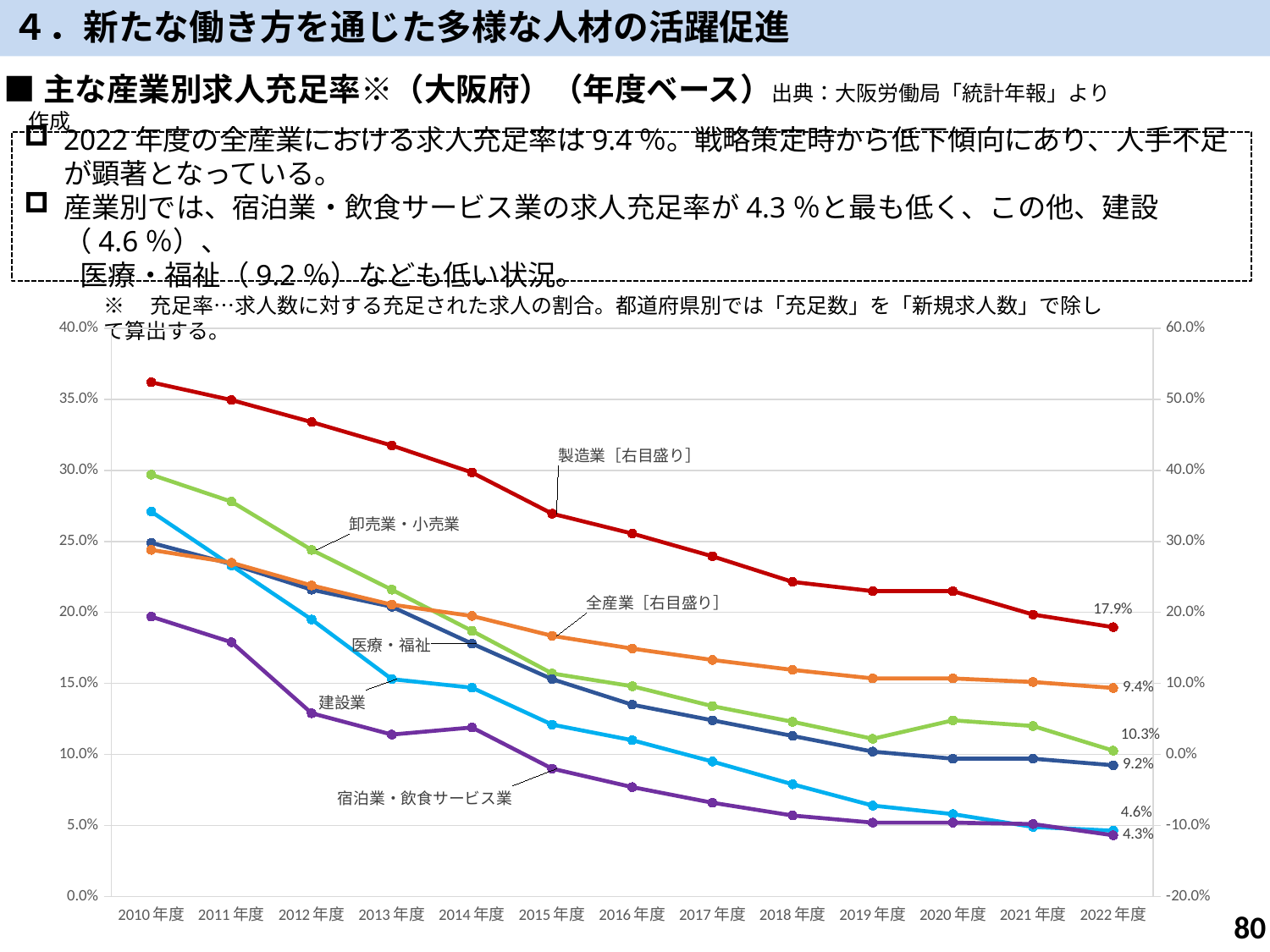
What is the difference between the 2022年度 values of 建設業 (4.6%) and 宿泊業・飲食サービス業 (4.3%)? 0.3% What is the 2022年度 value shown for 卸売業・小売業? 10.3% In 2022年度, which is larger: 卸売業・小売業 or 医療・福祉? 卸売業・小売業 What is the 2022年度 value shown for 全産業 (right axis)? 9.4% What is the 2022年度 value shown for 宿泊業・飲食サービス業? 4.3% What kind of chart is shown on the slide? line chart Does the 全産業 line rise or fall from 2010年度 to 2022年度? fall How many fiscal years are plotted on the x axis? 13 Is the 2010年度 value for 卸売業・小売業 greater or less than 25.0% on the left axis? greater What is the 2022年度 value shown for 製造業 (right axis)? 17.9% Which industry line has the lowest value in 2022年度? 宿泊業・飲食サービス業 What is the 2022年度 value shown for 建設業? 4.6%